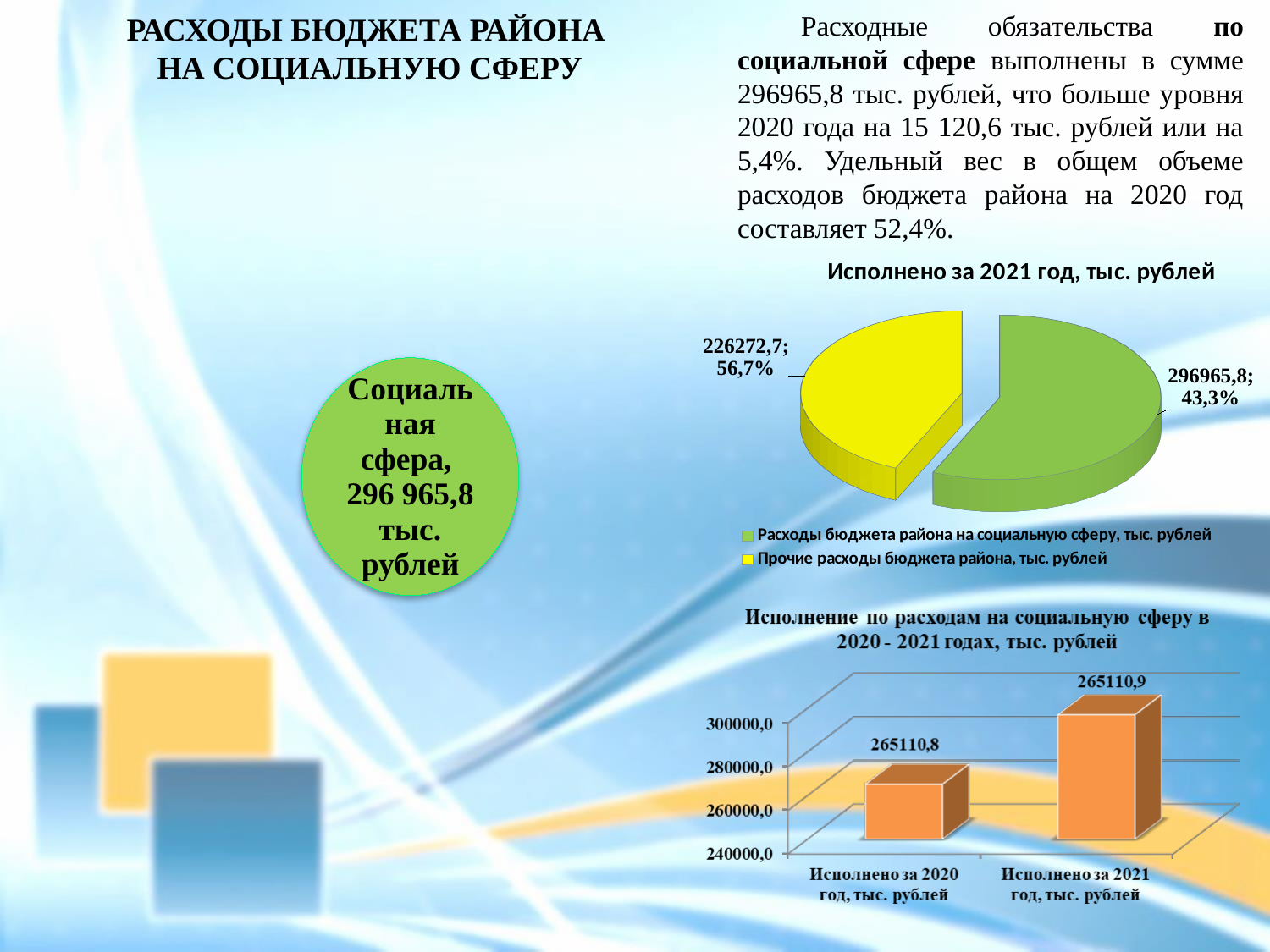
How many slices does the pie chart "Исполнено за 2021 год, тыс. рублей" have? 2 How many entries does the legend of the pie chart "Исполнено за 2021 год, тыс. рублей" list? 2 What type of chart is the chart titled "Исполнено за 2021 год, тыс. рублей"? pie chart In the bar chart "Исполнение по расходам на социальную сферу в 2020 - 2021 годах, тыс. рублей", what value is labelled on the bar "Исполнено за 2021 год, тыс. рублей"? 265110,9 In the pie chart "Исполнено за 2021 год, тыс. рублей", which colour represents "Прочие расходы бюджета района, тыс. рублей"? yellow In the pie chart "Исполнено за 2021 год, тыс. рублей", what value is shown for "Прочие расходы бюджета района, тыс. рублей"? 226272,7 What type of chart is the chart titled "Исполнение по расходам на социальную сферу в 2020 - 2021 годах, тыс. рублей"? bar chart In the pie chart "Исполнено за 2021 год, тыс. рублей", what is the difference between the two slice values, 296965,8 and 226272,7? 70693,1 In the pie chart "Исполнено за 2021 год, тыс. рублей", what value is shown for "Расходы бюджета района на социальную сферу, тыс. рублей"? 296965,8 In the bar chart "Исполнение по расходам на социальную сферу в 2020 - 2021 годах, тыс. рублей", what value is labelled on the bar "Исполнено за 2020 год, тыс. рублей"? 265110,8 In the pie chart "Исполнено за 2021 год, тыс. рублей", what percentage is printed next to the slice labelled 296965,8? 43,3% In the pie chart "Исполнено за 2021 год, тыс. рублей", what percentage is printed next to the slice labelled 226272,7? 56,7%